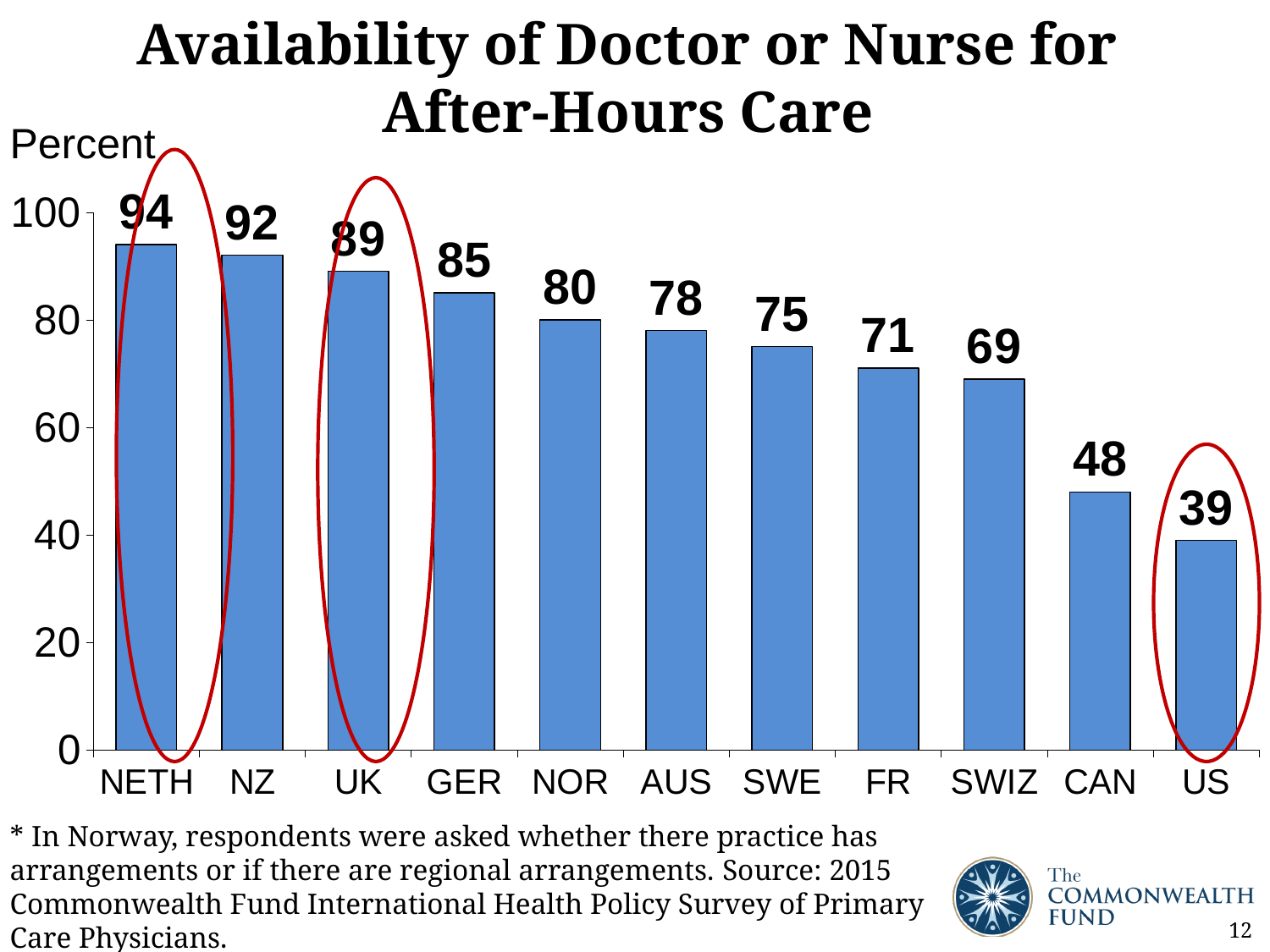
Which country has the highest value? NETH How many countries are shown on the chart? 11 What kind of chart is shown on the slide? bar chart Is the value for AUS greater or less than 60? greater What is the value for SWE? 75 What is the difference between the values for GER and FR? 14 What is the value for the UK? 89 Do the values rise or fall from left to right along the x axis? fall Which country has the lowest value? US Which is larger, the value for NOR or the value for SWIZ? NOR What is the difference between the values for NETH and US? 55 What is the value for CAN? 48